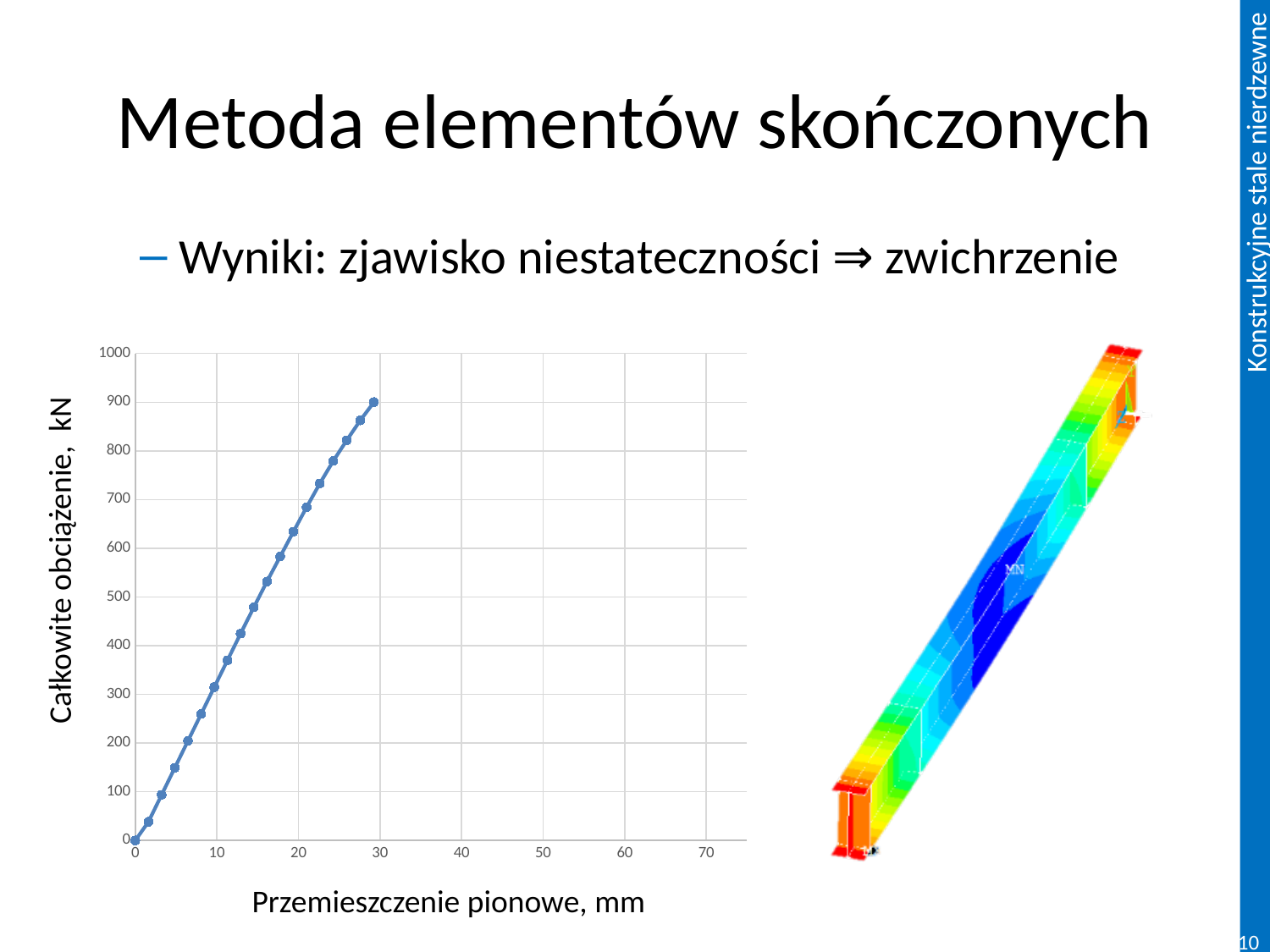
Is the load at a vertical displacement of 20 mm greater or less than 700 kN? less What is the maximum value shown on the y axis of the chart? 1000 Is the load at a vertical displacement of 10 mm greater or less than 500 kN? less Is the largest vertical displacement plotted on the chart greater or less than 40 mm? less How many data series are plotted on the chart? 1 What is the label of the y axis of the chart? Całkowite obciążenie, kN What kind of chart is shown on the slide? line chart What is the label of the x axis of the chart? Przemieszczenie pionowe, mm What is the load value at the first plotted point, at 0 mm displacement? 0 Does the total load rise or fall as the vertical displacement increases along the x axis? rise